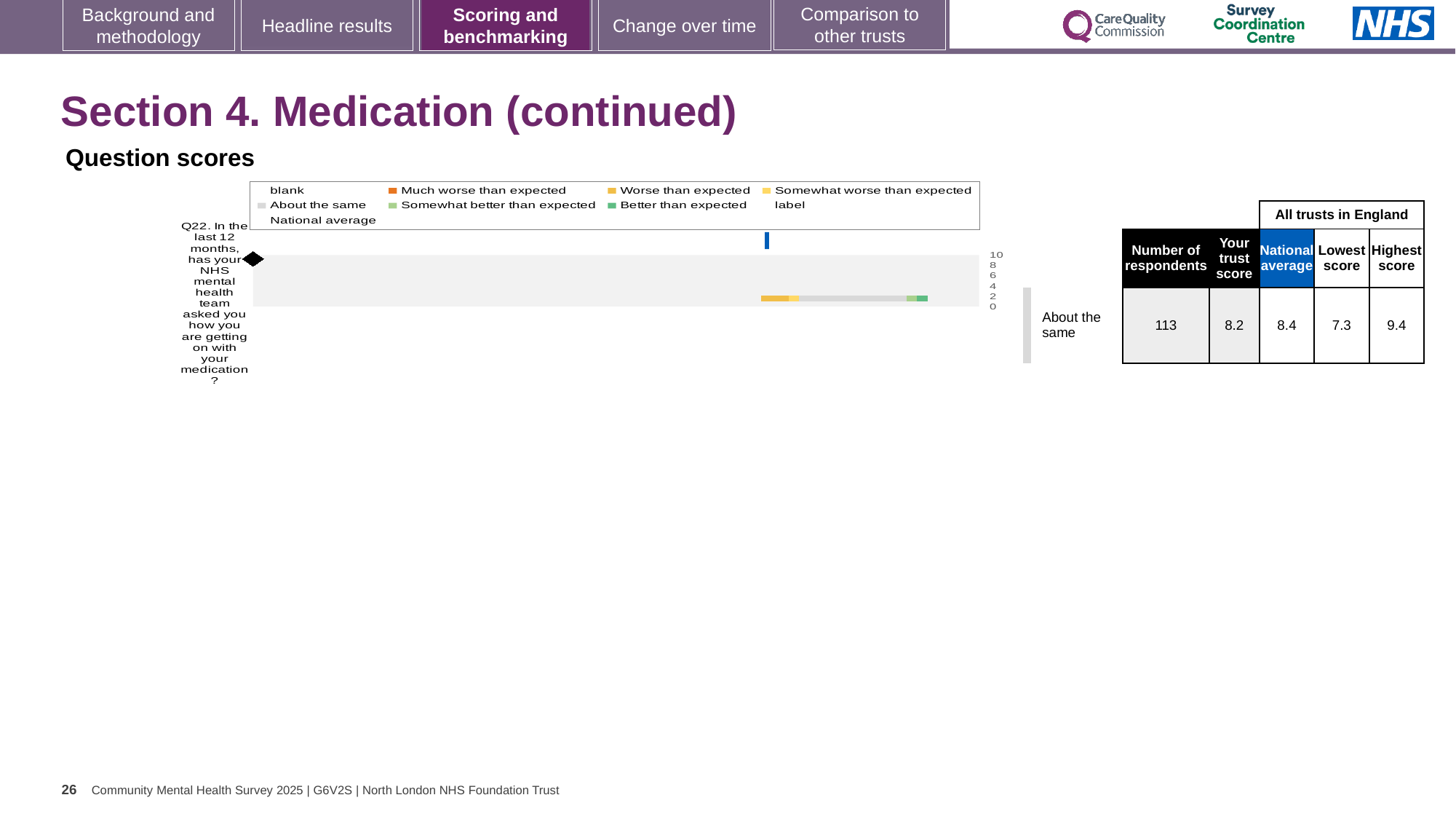
What is the highest score among all trusts in England for Q22? 9.4 What is the difference between the highest and lowest scores for Q22 across all trusts in England? 2.1 Which legend entry on the chart is shown in orange? Much worse than expected Which is larger for Q22, the trust score or the national average? national average What is the national average score for Q22? 8.4 What is the lowest score among all trusts in England for Q22? 7.3 Which benchmark category is Q22 assigned to on the chart? About the same What is the difference between the national average and the trust score for Q22? 0.2 How many respondents answered Q22? 113 How many questions are plotted on the question scores chart? 1 What is the trust's score for Q22 shown next to the chart? 8.2 What kind of chart is used to show the Q22 question score? bar chart